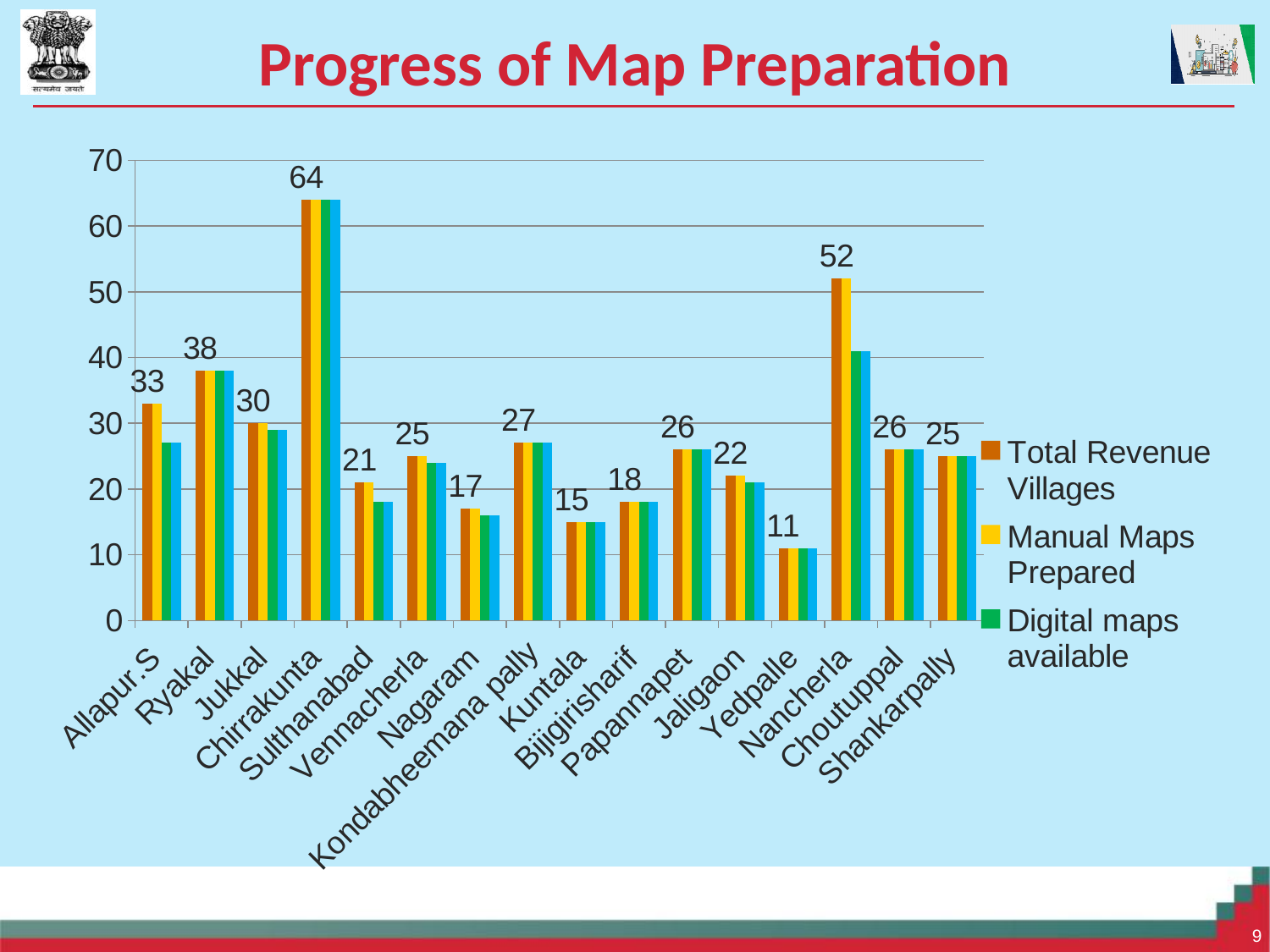
Which village has the lowest Total Revenue Villages value? Yedpalle How many series does the legend list? 3 What is the Total Revenue Villages value for Yedpalle? 11 Which has a larger Total Revenue Villages value, Ryakal or Jukkal? Ryakal What is the difference between the Total Revenue Villages values for Chirrakunta and Nancherla? 12 What is the Total Revenue Villages value for Nancherla? 52 Is the Digital maps available value for Allapur.S greater or less than 30? less How many villages are shown on the x axis? 16 What kind of chart is shown on the slide? Bar chart Which village has the highest Total Revenue Villages value? Chirrakunta What is the Total Revenue Villages value for Chirrakunta? 64 Is the Manual Maps Prepared value for Nancherla greater or less than 50? greater